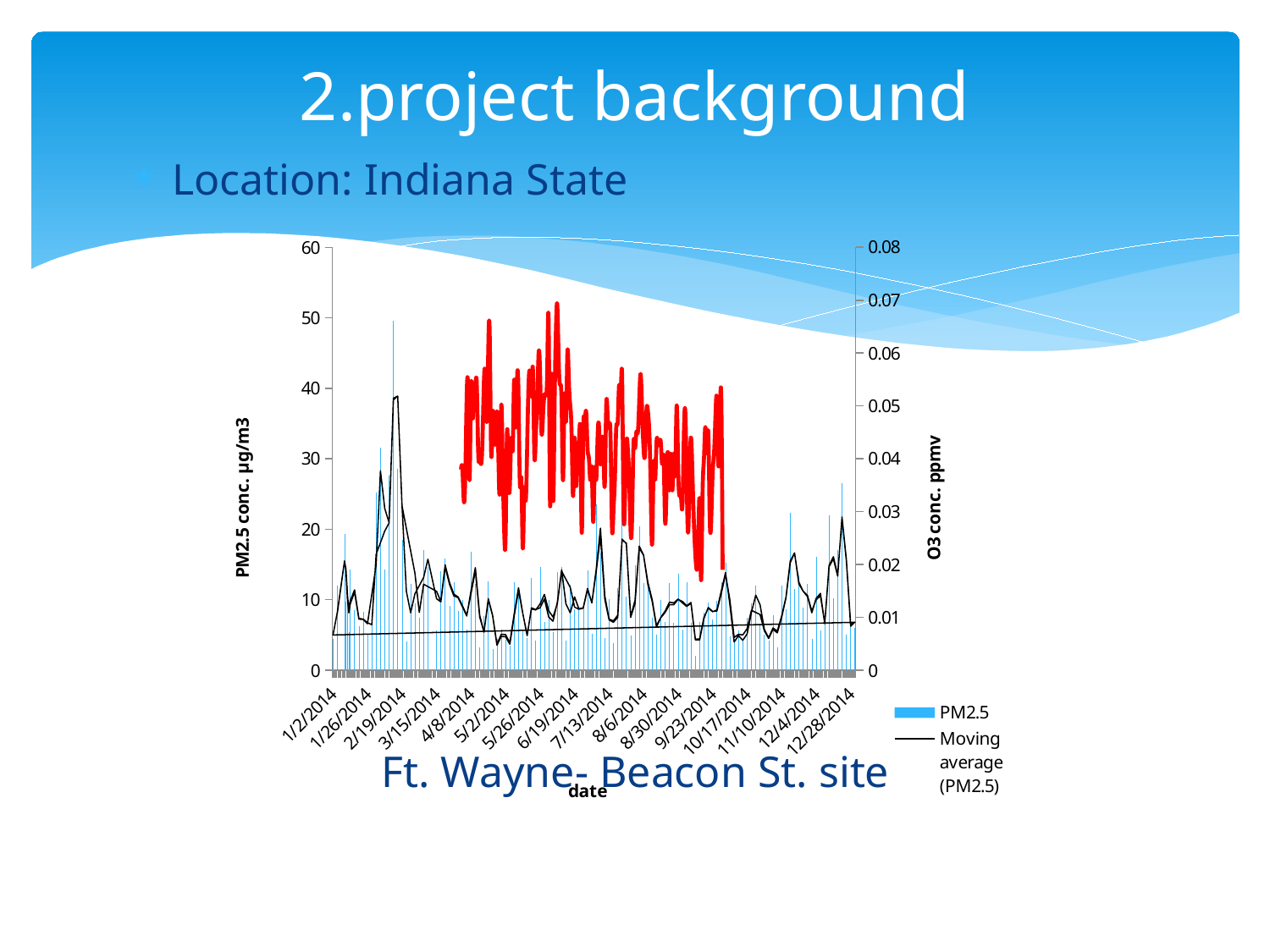
How many series does the legend list? 2 Is the highest PM2.5 bar (near 2/19/2014) greater or less than 40 µg/m3? greater What kind of chart is shown on the slide? A combined bar and line chart Does the thin straight trend line drawn across the chart rise or fall from left to right? rise What are the two entries in the chart legend? PM2.5 and Moving average (PM2.5) How many date labels are shown along the x axis? 16 Is the lowest point of the red line, read on the right axis, greater or less than 0.03 ppmv? less What is the title of the left vertical axis? PM2.5 conc. µg/m3 Is the peak of the red line, read on the right axis, greater or less than 0.06 ppmv? greater